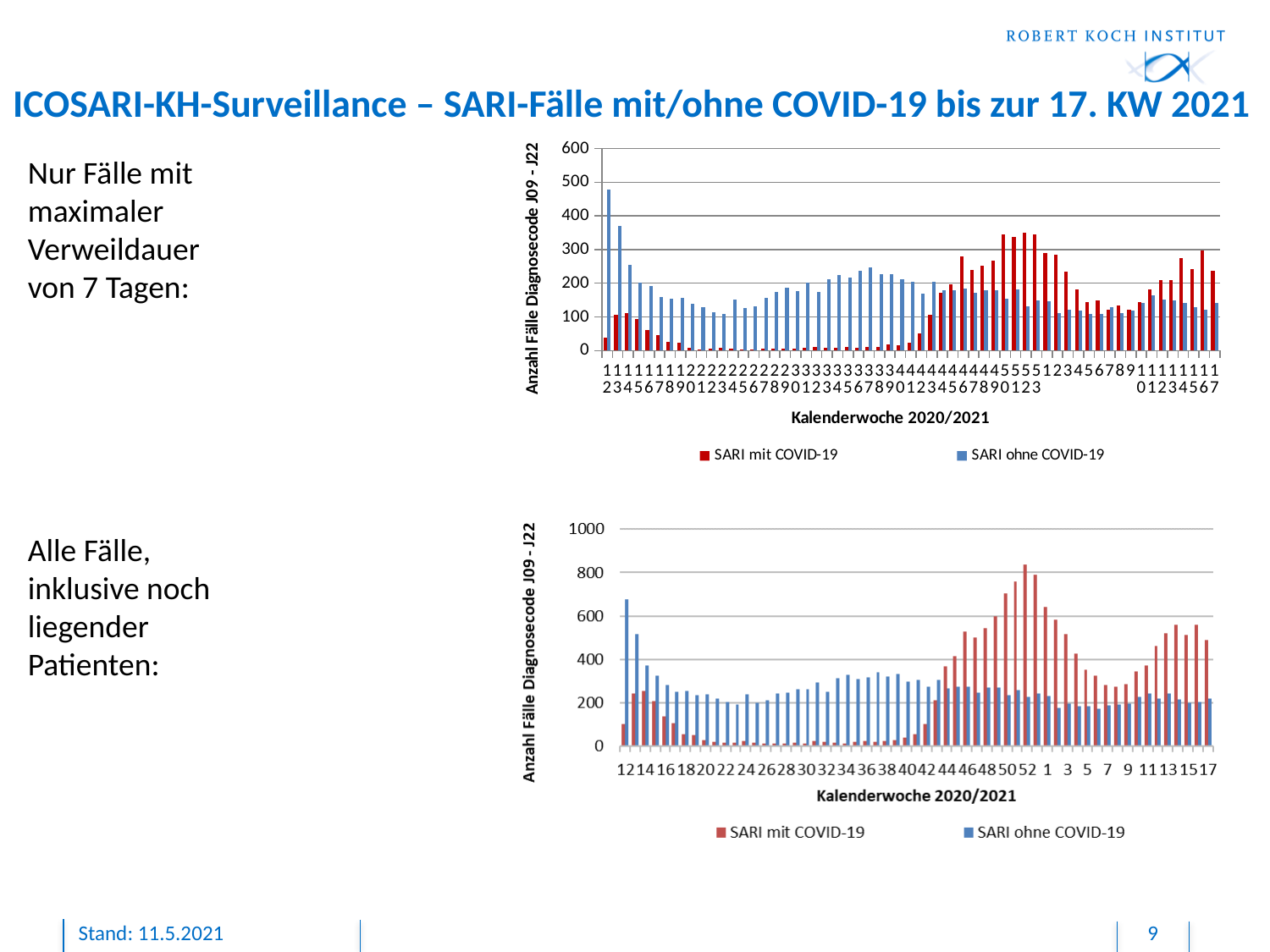
In the upper chart, which calendar week has the highest value for SARI ohne COVID-19? 12 What is the x-axis title of the lower chart? Kalenderwoche 2020/2021 What kind of chart is the upper chart on the slide? bar chart In the lower chart, in calendar week 2, which series has the larger value, SARI mit COVID-19 or SARI ohne COVID-19? SARI mit COVID-19 In the lower chart, which calendar week has the highest value for SARI mit COVID-19? 52 How many series does the legend of the lower chart list? 2 In the lower chart, is the value for SARI ohne COVID-19 in calendar week 46 greater or less than 400? less What are the two series named in the legend of the upper chart? SARI mit COVID-19 and SARI ohne COVID-19 In the upper chart, in calendar week 12, which series has the larger value, SARI mit COVID-19 or SARI ohne COVID-19? SARI ohne COVID-19 In the upper chart, is the value for SARI ohne COVID-19 in calendar week 12 greater or less than 400? greater In the lower chart, is the value for SARI ohne COVID-19 in calendar week 12 greater or less than 600? greater